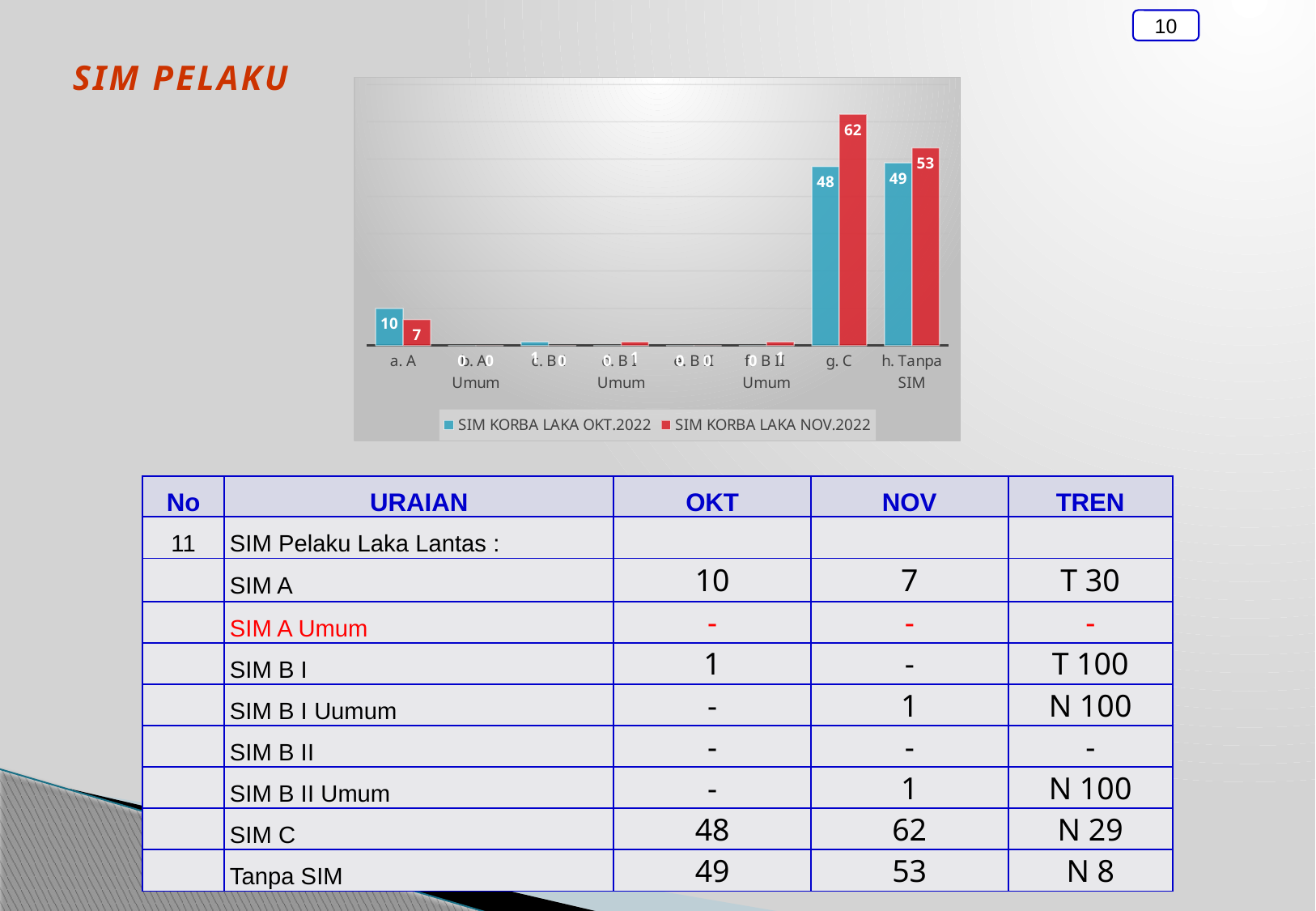
What is the value for SIM KORBA LAKA NOV.2022 in category g. C? 62 What is the value for SIM KORBA LAKA OKT.2022 in category a. A? 10 Which colour represents the SIM KORBA LAKA NOV.2022 series in the chart? red What is the difference between the SIM KORBA LAKA NOV.2022 and SIM KORBA LAKA OKT.2022 values in category g. C? 14 What type of chart is shown on the slide? bar chart What is the value for SIM KORBA LAKA NOV.2022 in category a. A? 7 How many series does the chart legend list? 2 What is the value for SIM KORBA LAKA OKT.2022 in category h. Tanpa SIM? 49 In category h. Tanpa SIM, which series has the larger value, SIM KORBA LAKA OKT.2022 or SIM KORBA LAKA NOV.2022? SIM KORBA LAKA NOV.2022 What is the difference between the SIM KORBA LAKA OKT.2022 values for h. Tanpa SIM and a. A? 39 Which category has the highest value for SIM KORBA LAKA NOV.2022? g. C How many categories are shown on the x axis of the chart? 8